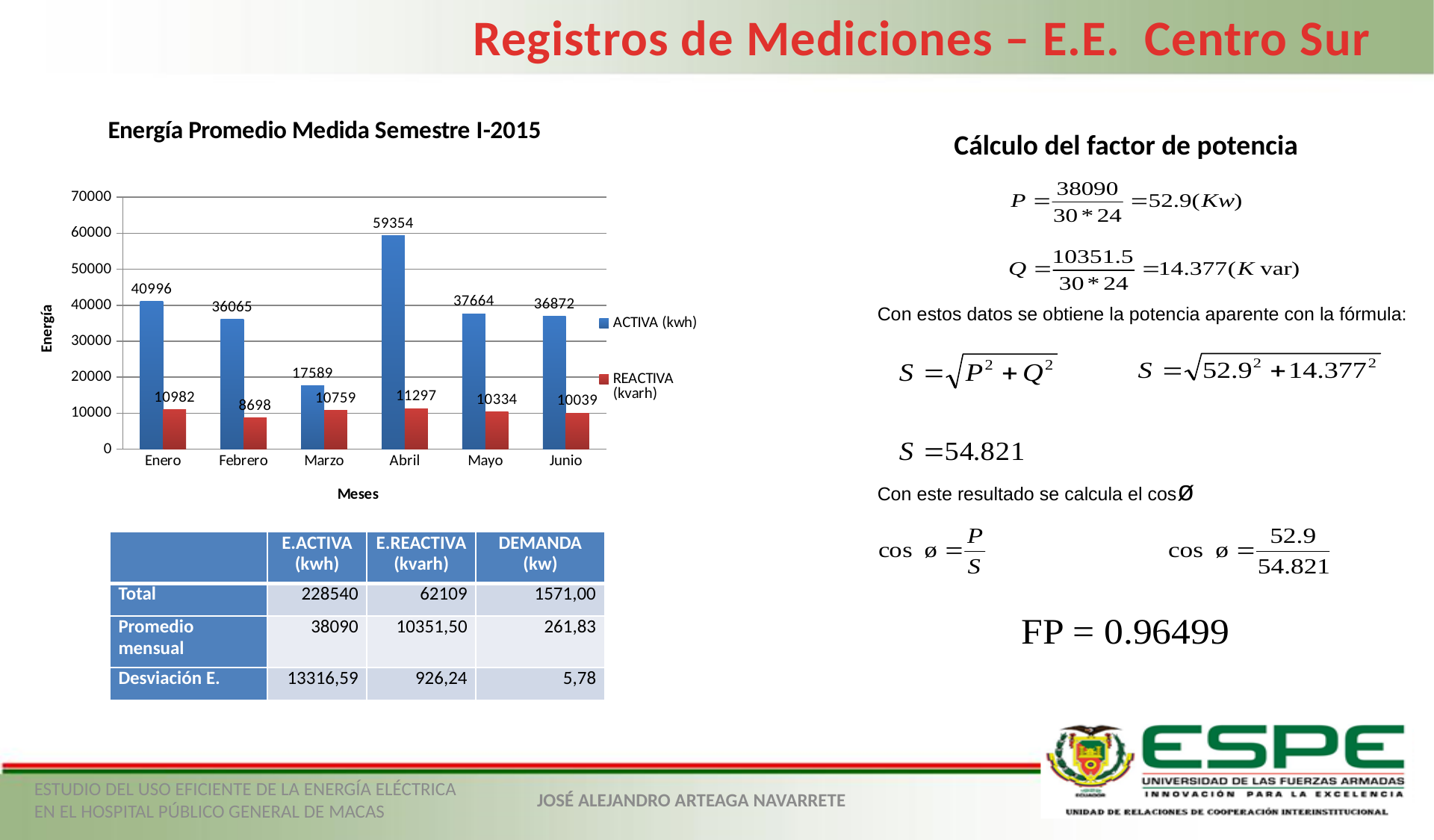
How many months are shown on the x axis of the chart? 6 How many series does the chart legend list? 2 What is the REACTIVA (kvarh) value for Febrero? 8698 Which is larger, the ACTIVA (kwh) value for Enero or for Mayo? Enero What is the title of the chart? Energía Promedio Medida Semestre I-2015 Which month has the lowest ACTIVA (kwh) value? Marzo What kind of chart is shown on the slide? bar chart Which month has the lowest REACTIVA (kvarh) value? Febrero What is the ACTIVA (kwh) value for Abril? 59354 Which month has the highest ACTIVA (kwh) value? Abril What is the difference between the ACTIVA (kwh) values for Abril and Marzo? 41765 Is the ACTIVA (kwh) value for Marzo greater or less than 20000? less